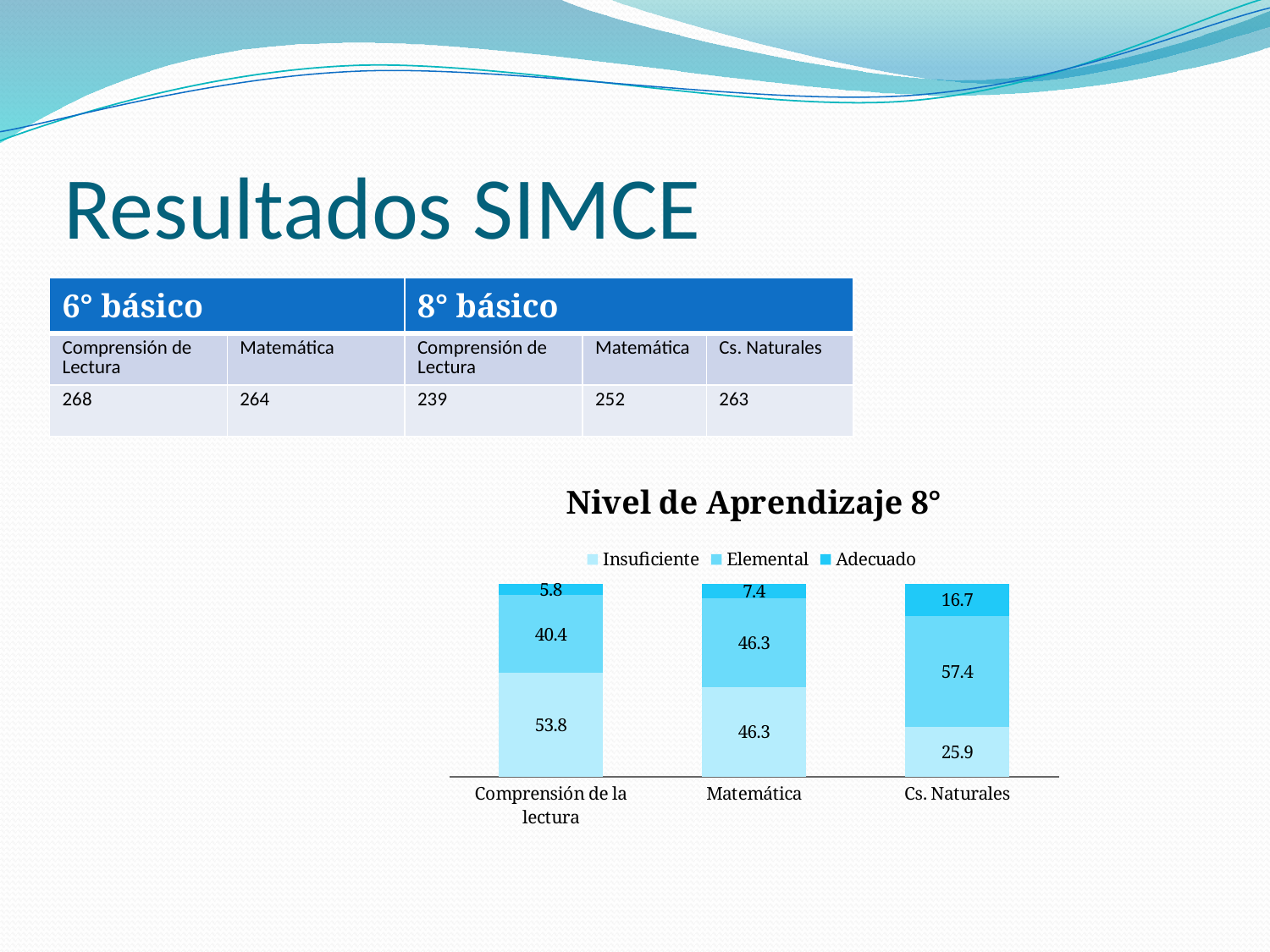
In the "Nivel de Aprendizaje 8°" chart, is the Insuficiente value larger for Comprensión de la lectura or for Matemática? Comprensión de la lectura What is the Elemental value for Matemática in the "Nivel de Aprendizaje 8°" chart? 46.3 In the "Nivel de Aprendizaje 8°" chart, what is the difference between the Elemental values for Cs. Naturales and Comprensión de la lectura? 17.0 Which series is listed first in the legend of the "Nivel de Aprendizaje 8°" chart? Insuficiente What is the Adecuado value for Cs. Naturales in the "Nivel de Aprendizaje 8°" chart? 16.7 What type of chart is shown under the title "Nivel de Aprendizaje 8°"? Stacked bar chart Which category has the lowest Insuficiente value in the "Nivel de Aprendizaje 8°" chart? Cs. Naturales What is the Insuficiente value for Comprensión de la lectura in the "Nivel de Aprendizaje 8°" chart? 53.8 Which category has the highest Adecuado value in the "Nivel de Aprendizaje 8°" chart? Cs. Naturales What is the total of the stacked bar for Cs. Naturales in the "Nivel de Aprendizaje 8°" chart? 100 How many series does the legend of the "Nivel de Aprendizaje 8°" chart list? 3 How many categories are shown on the x axis of the "Nivel de Aprendizaje 8°" chart? 3